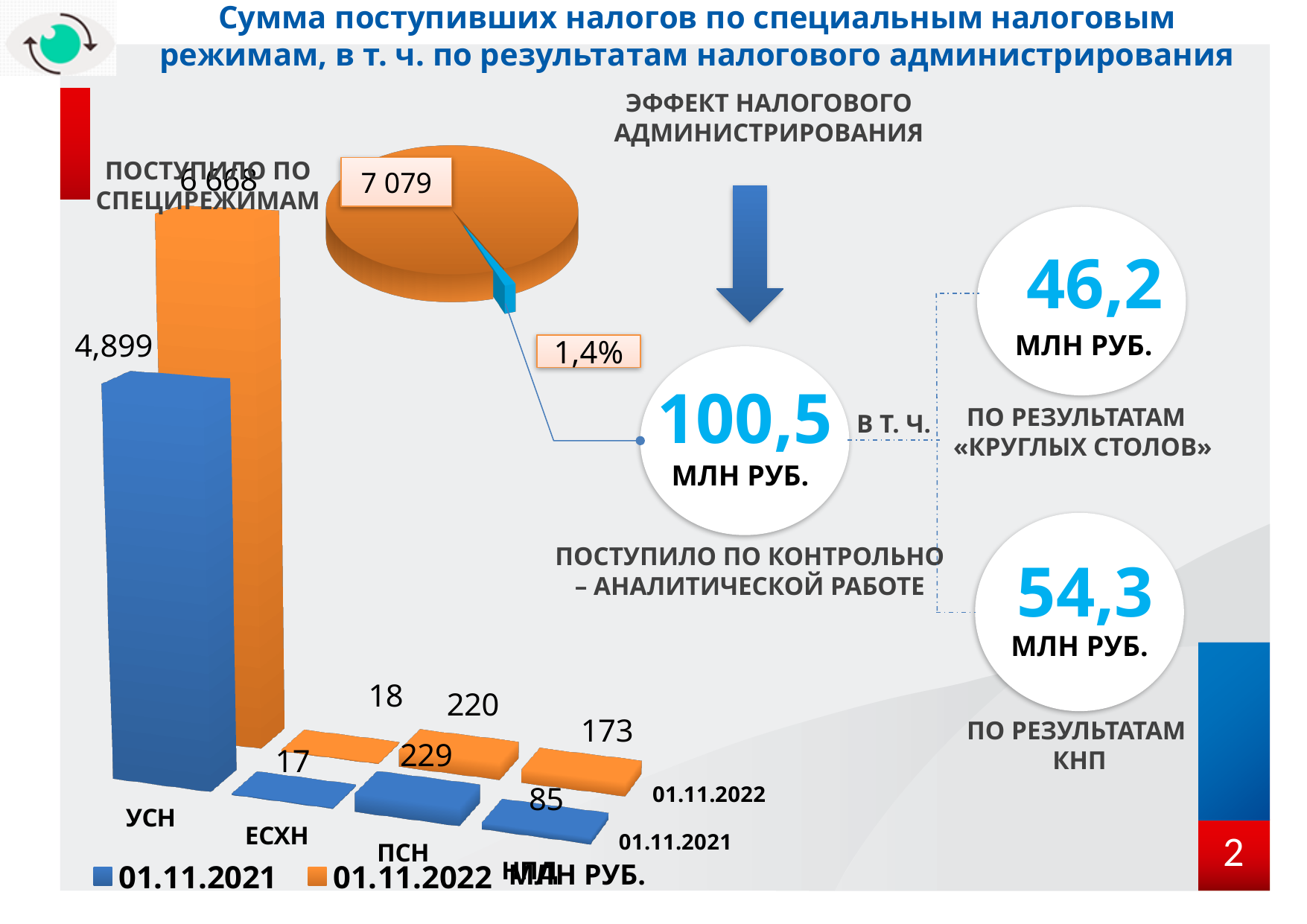
In the bar chart, which series has the larger value for УСН, 01.11.2021 or 01.11.2022? 01.11.2022 In the bar chart, what is the value for ЕСХН in the 01.11.2022 series? 18 In the pie chart, what share does the small blue slice represent? 1,4% How many series does the bar chart legend list? 2 In the bar chart, which category has the highest value in the 01.11.2022 series? УСН In the bar chart, what is the value for УСН in the 01.11.2022 series? 6 668 In the bar chart, what is the difference between the 01.11.2021 and 01.11.2022 values for ПСН? 9 What kind of chart is the chart with the categories УСН, ЕСХН and ПСН? bar chart How many categories are shown in the bar chart? 4 In the bar chart, what is the value for ПСН in the 01.11.2021 series? 229 In the bar chart, what is the value for УСН in the 01.11.2021 series? 4,899 In the bar chart, which category has the lowest value in the 01.11.2021 series? ЕСХН